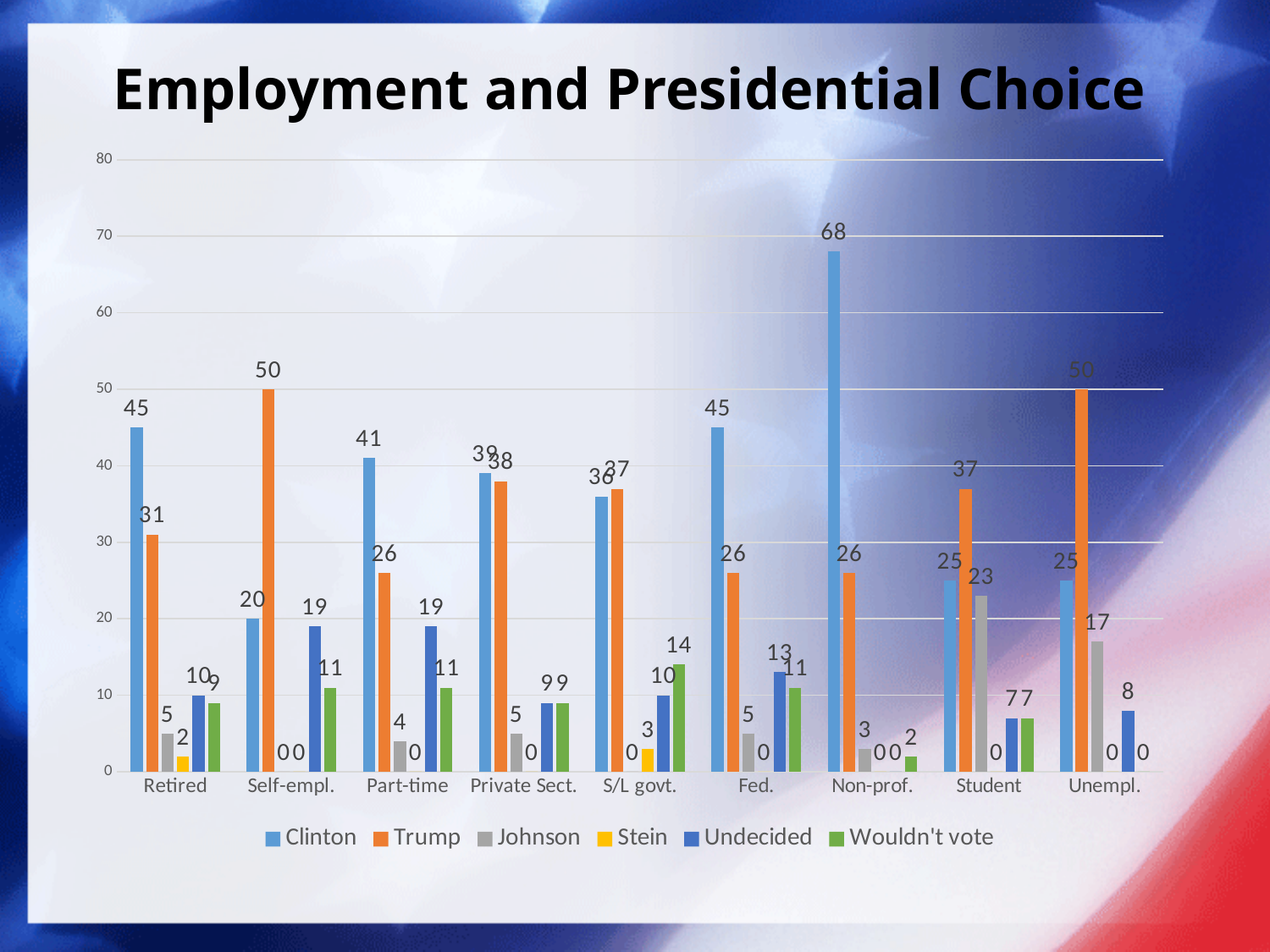
In which employment category does Clinton have the highest value? Non-prof. How many series does the legend list? 6 In which employment category does Clinton have the lowest value? Student and Unempl. (25 each) What is the value for Undecided in the Fed. category? 13 Which is larger in the Part-time category, Clinton or Trump? Clinton What is the value for Clinton in the Non-prof. category? 68 What is the value for Trump in the Self-empl. category? 50 What is the value for Johnson in the Student category? 23 How many employment categories are shown on the x axis? 9 What kind of chart is shown on the slide? Bar chart What is the title of the chart? Employment and Presidential Choice What is the difference between the Clinton and Trump values in the Retired category? 14